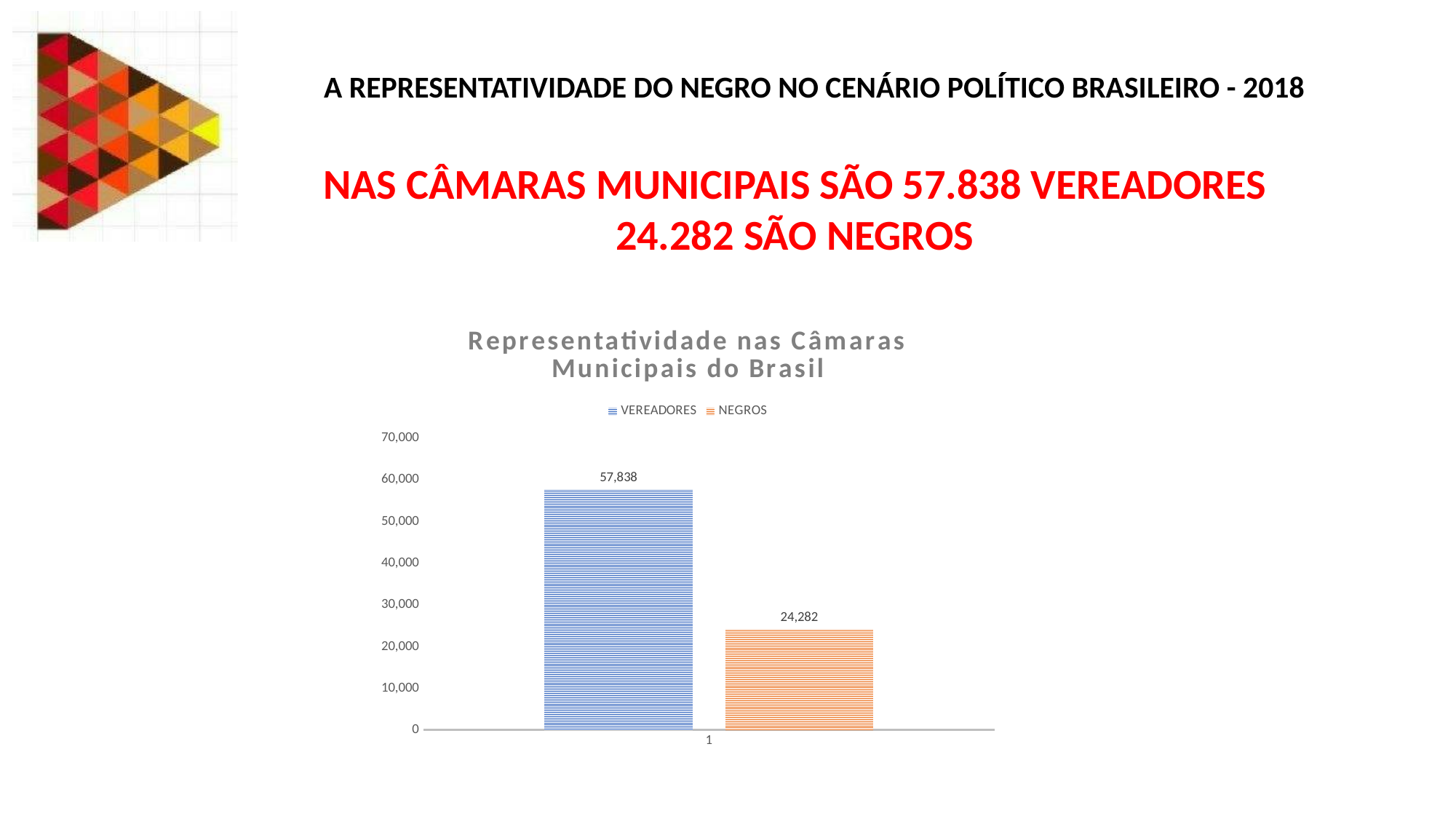
Is the value for VEREADORES greater or less than 50,000? greater Which series has the lowest value in the chart? NEGROS Is the value for NEGROS greater or less than 30,000? less Which series has the higher value, VEREADORES or NEGROS? VEREADORES What is the title of the chart? Representatividade nas Câmaras Municipais do Brasil What colour is the NEGROS bar in the chart? orange What is the value for VEREADORES in the chart? 57,838 What is the difference between the VEREADORES value and the NEGROS value? 33,556 What is the value for NEGROS in the chart? 24,282 How many series does the legend list? 2 What is the highest value shown on the vertical axis of the chart? 70,000 What kind of chart is shown on the slide? bar chart